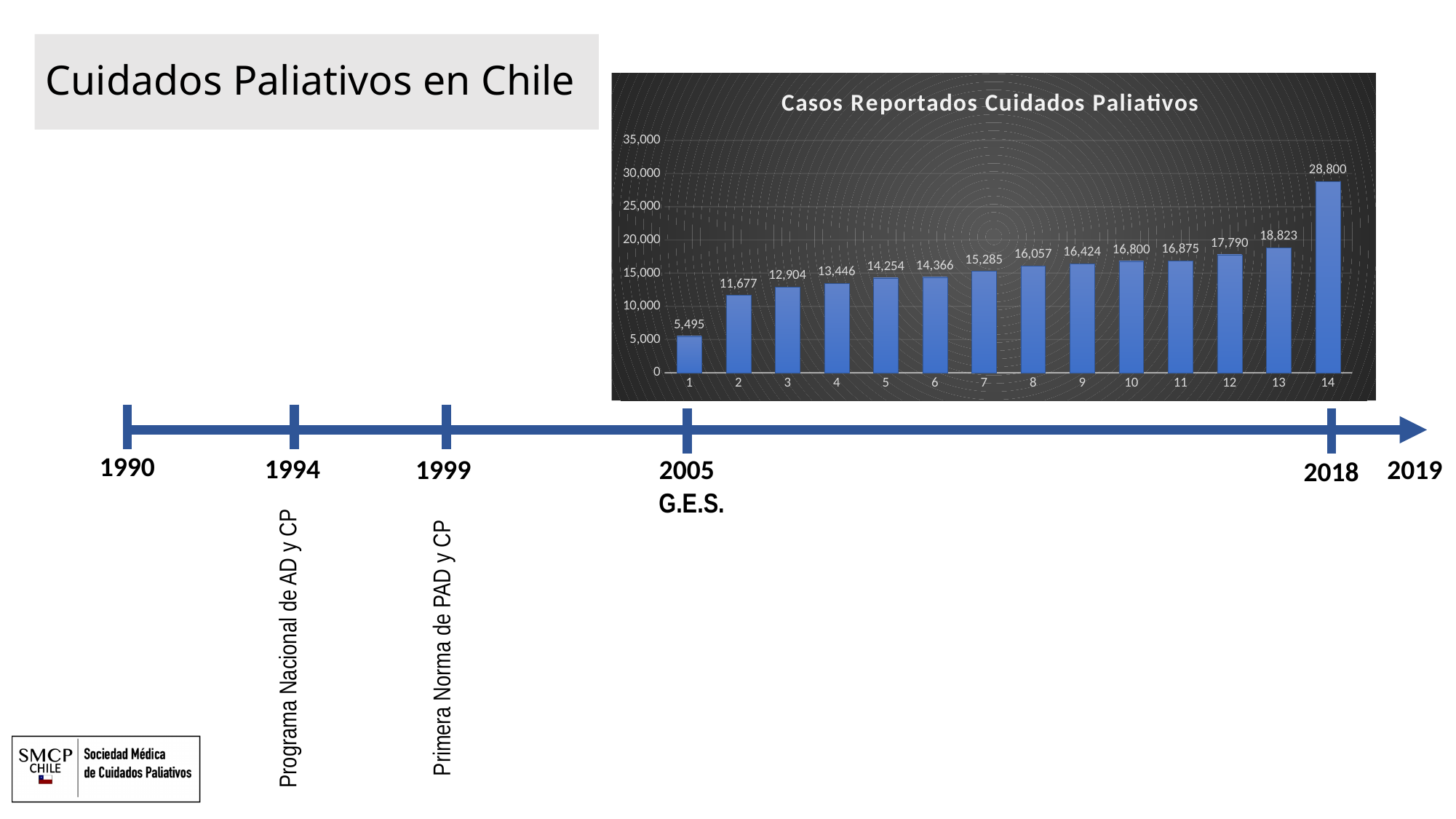
Is the value for category 2 greater or less than 10,000? greater What type of chart is shown on the slide? bar chart What is the value for category 13? 18,823 Which category has the highest value? 14 What is the value for category 7? 15,285 Which is larger, the value for category 4 or the value for category 9? category 9 What is the difference between the values for category 14 and category 13? 9,977 Which category has the lowest value? 1 What is the value for category 1? 5,495 How many bars are plotted in the chart? 14 Do the values rise or fall from category 1 to category 14? rise What is the title of the chart? Casos Reportados Cuidados Paliativos